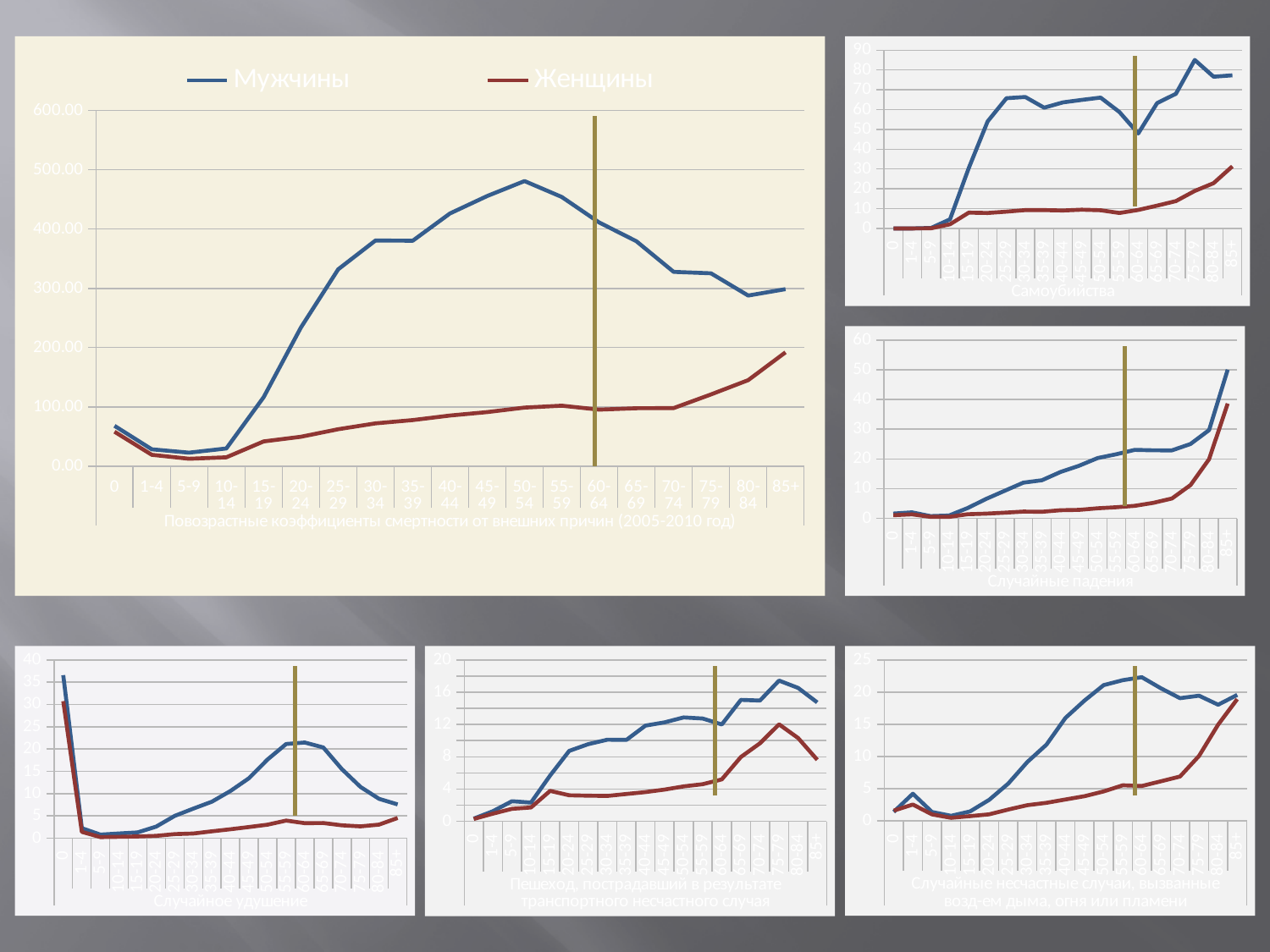
In the large chart 'Повозрастные коэффициенты смертности от внешних причин (2005-2010 год)', is the value for Мужчины at 50-54 greater or less than 400.00? greater In the chart 'Случайные несчастные случаи, вызванные возд-ем дыма, огня или пламени', is the value of the blue (Мужчины) line at 60-64 greater or less than 20? greater In the chart 'Случайное удушение', which age category has the highest value for the blue (Мужчины) line? 0 How many series does the legend of the large chart 'Повозрастные коэффициенты смертности от внешних причин (2005-2010 год)' list? 2 In the chart 'Случайные падения', is the value of the blue (Мужчины) line at 85+ greater or less than 40? greater In the large chart 'Повозрастные коэффициенты смертности от внешних причин (2005-2010 год)', which series is higher at 50-54, Мужчины or Женщины? Мужчины How many age categories are shown on the x axis of the large chart 'Повозрастные коэффициенты смертности от внешних причин (2005-2010 год)'? 19 What kind of chart is the large chart titled 'Повозрастные коэффициенты смертности от внешних причин (2005-2010 год)'? line chart In the chart 'Самоубийства', which age category has the highest value for the blue (Мужчины) line? 75-79 In the large chart 'Повозрастные коэффициенты смертности от внешних причин (2005-2010 год)', which age category has the highest value for Мужчины? 50-54